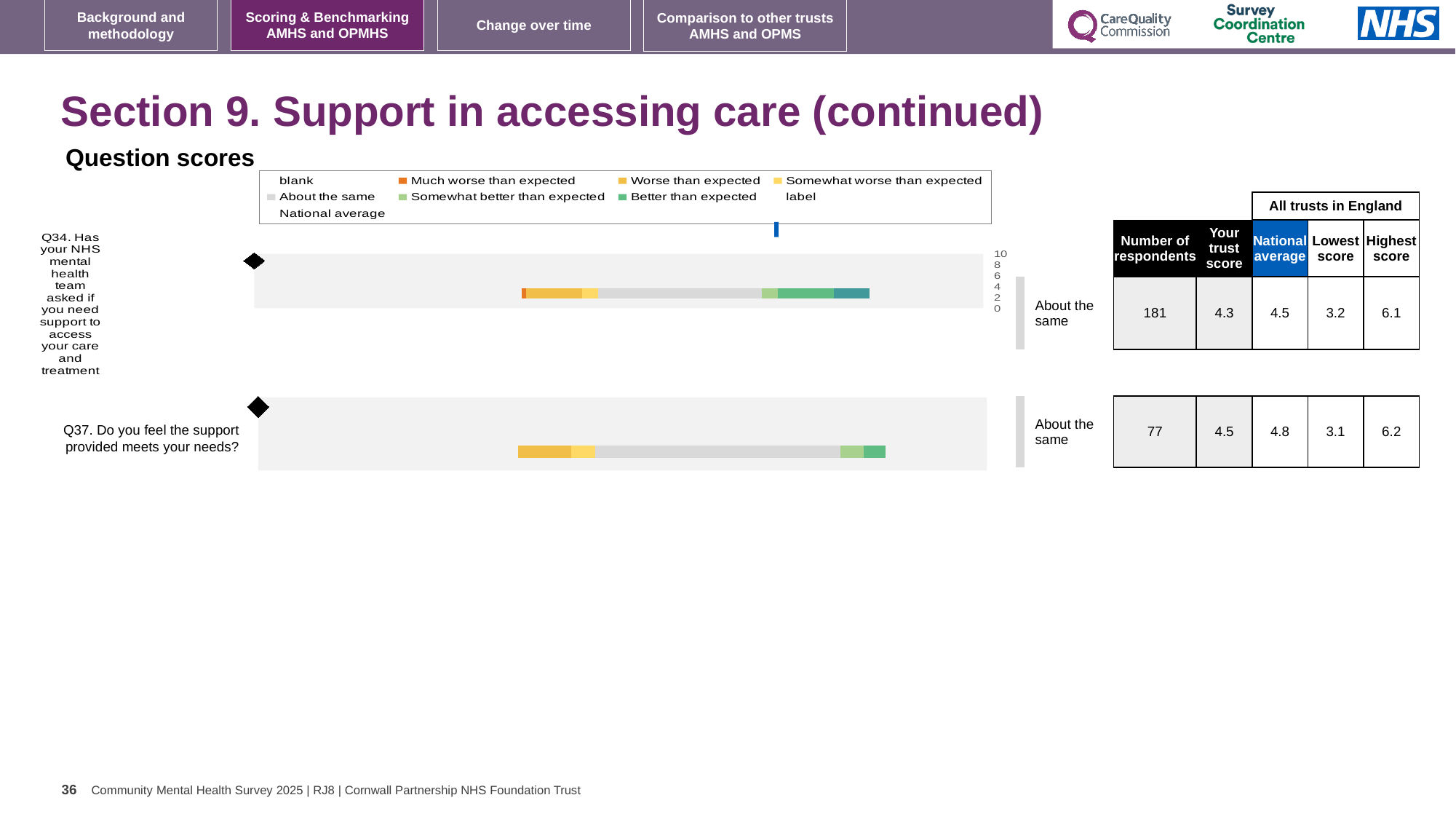
What category label is shown to the right of the Q37 chart bar? About the same What category label is shown to the right of the Q34 chart bar? About the same For Q37, what is the national average score? 4.8 For Q34, what is the difference between the national average and the trust score? 0.2 What kind of chart is used to show the question scores on this slide? bar chart For Q34 (Has your NHS mental health team asked if you need support to access your care and treatment), what is the trust score marked on the chart? 4.3 Which question has the higher highest score across all trusts in England, Q34 or Q37? Q37 For Q37, what is the difference between the national average and the trust score? 0.3 For Q34, what is the national average score? 4.5 For Q34, which is larger: the trust score or the national average? national average How many questions are plotted in the question scores charts on this slide? 2 For Q37 (Do you feel the support provided meets your needs?), what is the trust score marked on the chart? 4.5